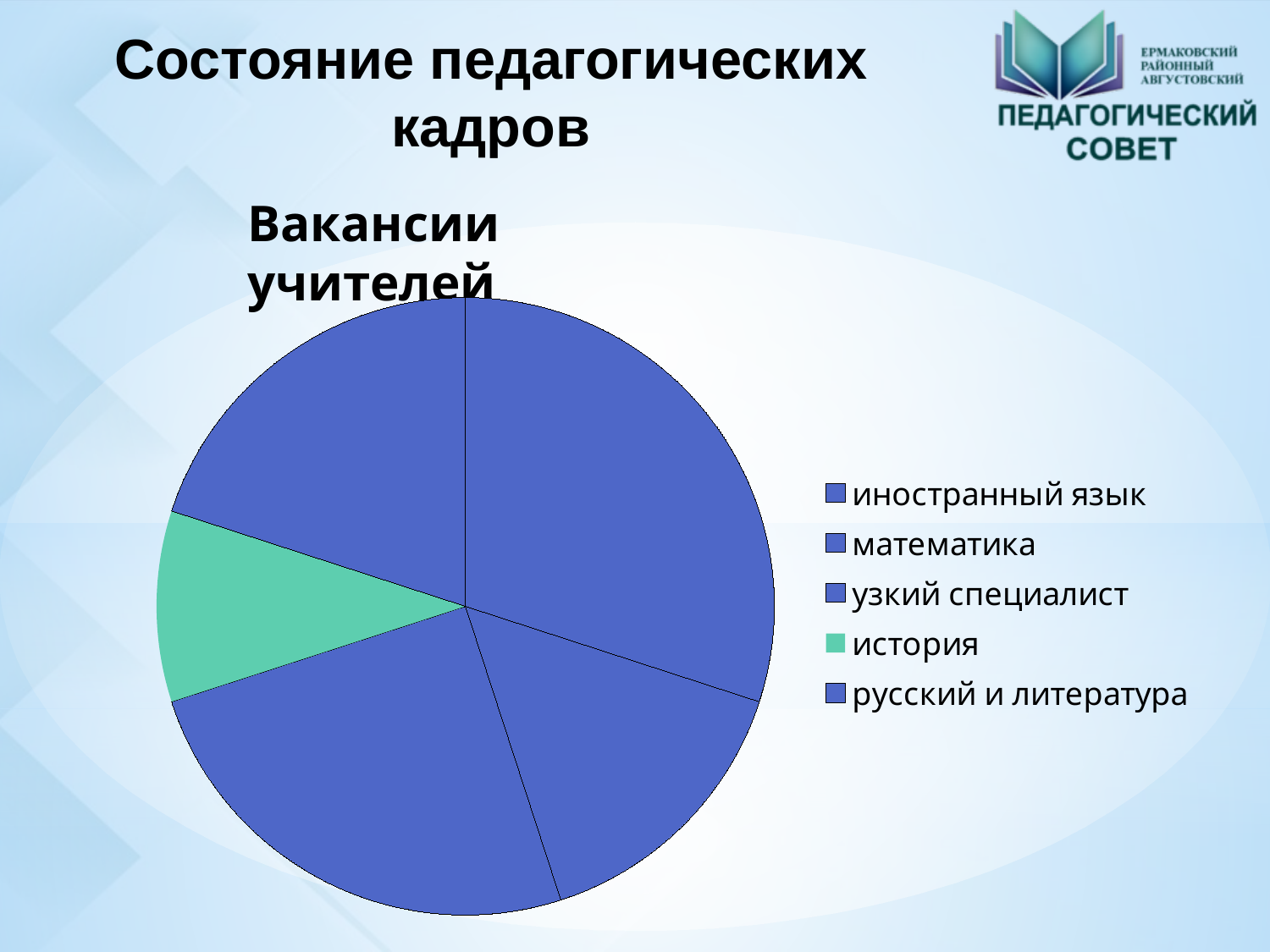
Which category is listed first in the legend? иностранный язык What is the title of the chart? Вакансии учителей Which category has the smallest slice of the pie? история How many entries does the legend list? 5 How many slices does the pie chart have? 5 Which category is shown in green in the pie chart? история What kind of chart is shown on the slide? pie chart